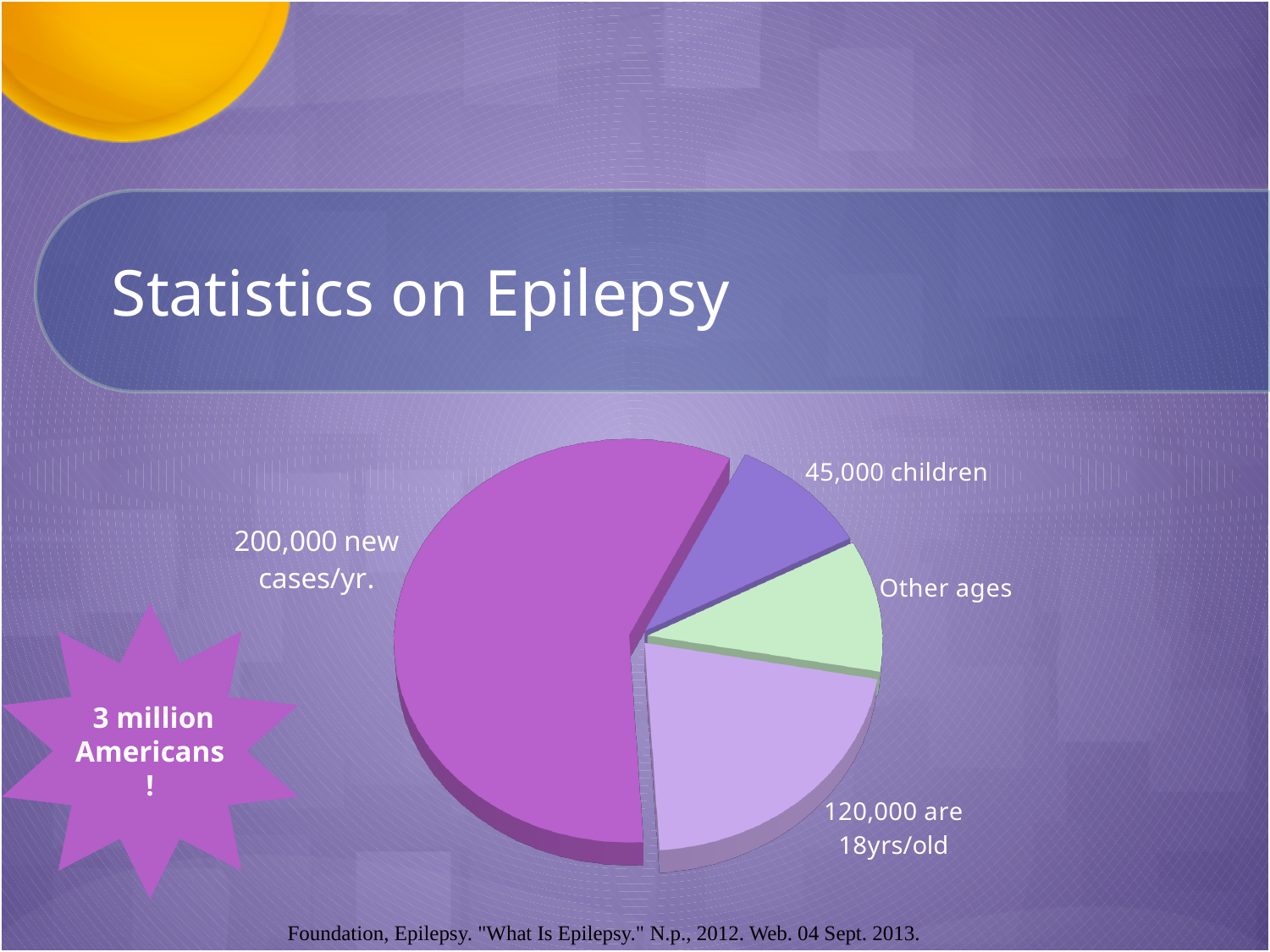
How many slices does the pie chart have? 4 Which is larger: the slice for new cases per year or the slice for those 18yrs/old? 200,000 new cases/yr. How many new cases per year does the pie chart label show? 200,000 Which slice of the pie chart is the largest? 200,000 new cases/yr. Which slice of the pie chart is coloured green? Other ages Which is larger: the slice for 18yrs/old or the slice for children? 120,000 are 18yrs/old What kind of chart is shown on the slide? Pie chart How many children are represented by the blue slice of the pie chart? 45,000 What is the difference between the 120,000 18yrs/old value and the 45,000 children value? 75,000 What is the title of the slide containing the pie chart? Statistics on Epilepsy What is the difference between the 200,000 new cases/yr. value and the 120,000 18yrs/old value? 80,000 How many people in the pie chart are 18yrs/old? 120,000